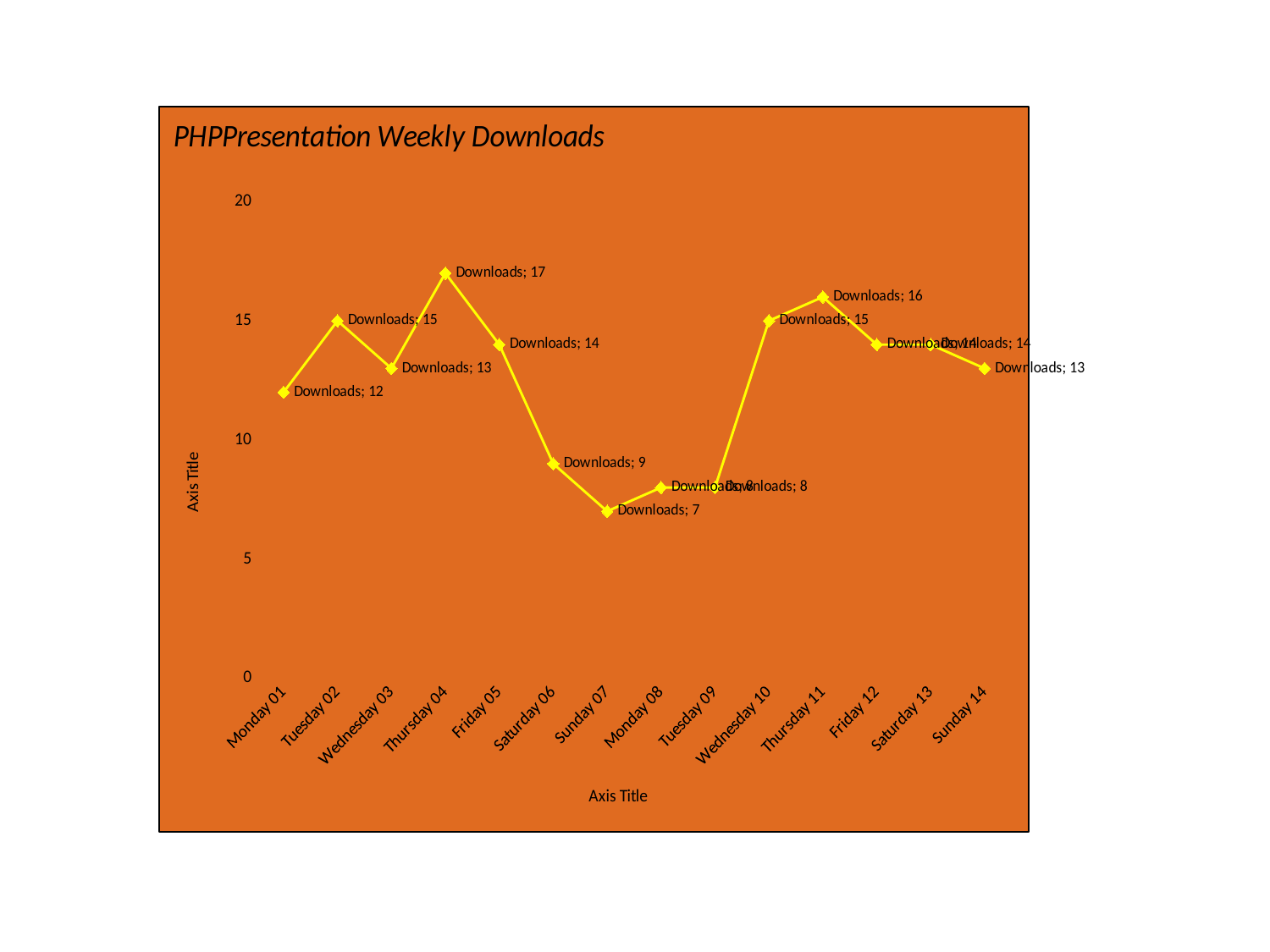
What is the Downloads value for Sunday 07? 7 What is the Downloads value for Thursday 04? 17 What is the Downloads value for Sunday 14? 13 Which has more downloads, Tuesday 02 or Wednesday 03? Tuesday 02 What is the Downloads value for Monday 01? 12 Do downloads rise or fall from Friday 05 to Sunday 07? Fall What is the difference in downloads between Thursday 04 and Sunday 07? 10 Which day has the highest number of downloads? Thursday 04 What type of chart is shown on the slide? Line chart What is the title of the chart? PHPPresentation Weekly Downloads Which day has the lowest number of downloads? Sunday 07 How many data points are plotted on the chart? 14